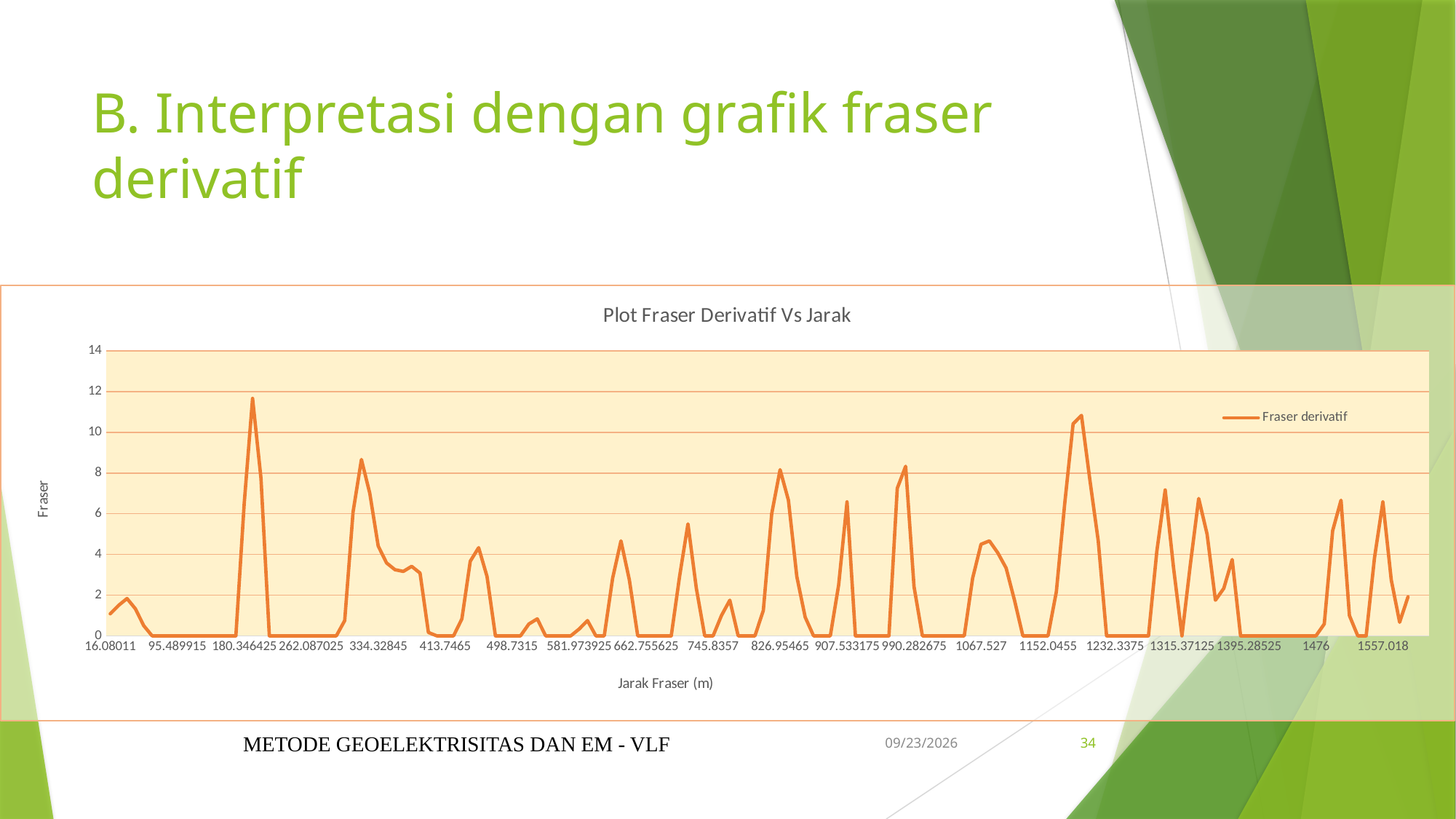
Is the value of the Fraser derivatif line at 16.08011 greater or less than 2? less Is the peak of the Fraser derivatif line near 334.32845 greater or less than 10? less Near which x-axis label does the Fraser derivatif line reach its highest peak? 180.346425 How many series does the legend list? 1 What is the highest value shown on the y axis? 14 What is the label of the x axis? Jarak Fraser (m) What is the label of the y axis? Fraser Is the highest peak of the Fraser derivatif line greater or less than 10? greater What kind of chart is shown on the slide? line chart What is the title of the chart? Plot Fraser Derivatif Vs Jarak What is the name of the series shown in the legend? Fraser derivatif